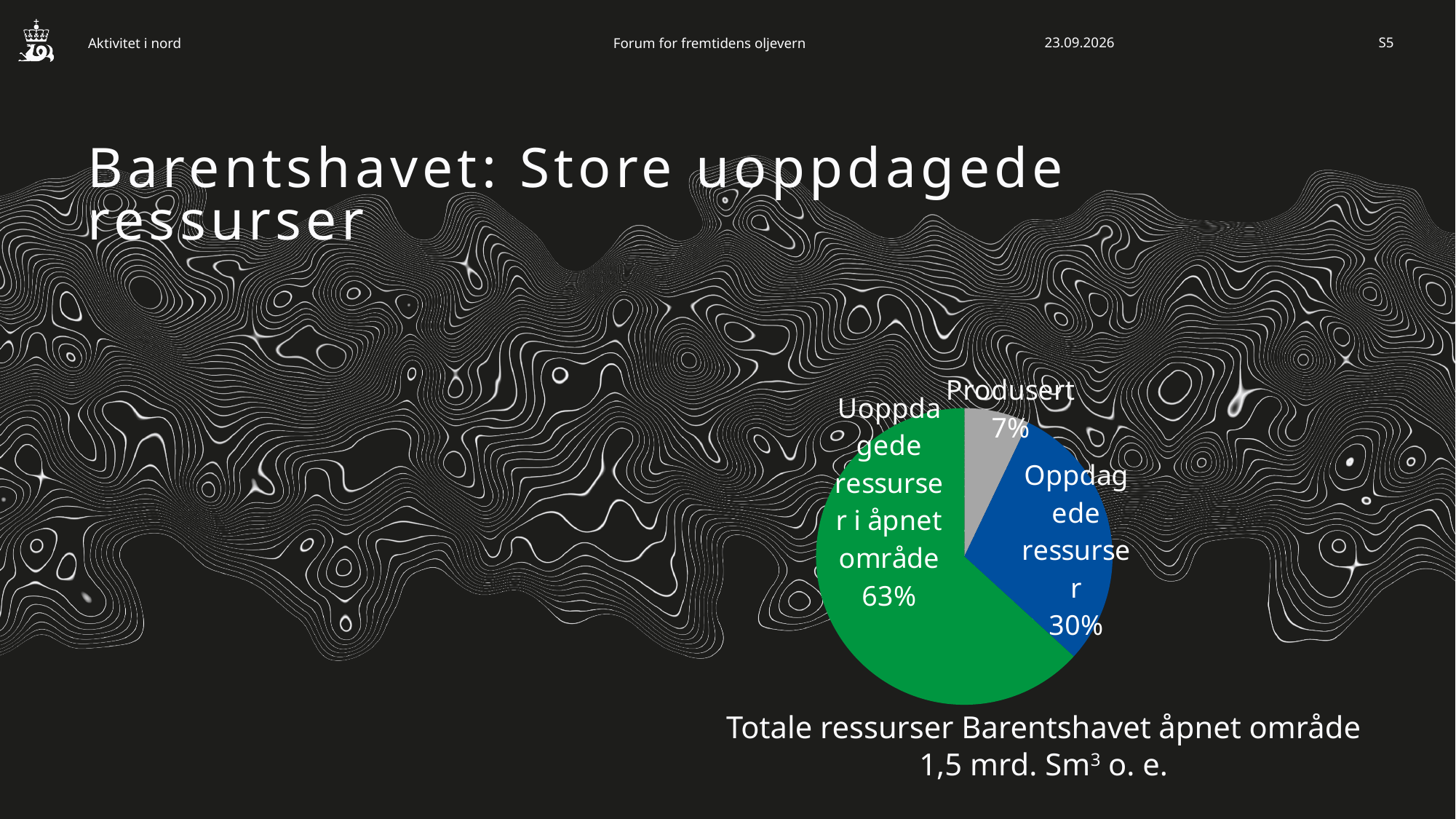
Which slice of the pie chart is the smallest? Produsert What is the difference in percentage points between the "Uoppdagede ressurser i åpnet område" slice and the "Oppdagede ressurser" slice? 33 percentage points What share of the pie is labelled "Uoppdagede ressurser i åpnet område"? 63% How many slices does the pie chart have? 3 What colour is the "Uoppdagede ressurser i åpnet område" slice? Green Which is larger: the "Oppdagede ressurser" slice or the "Produsert" slice? Oppdagede ressurser What is the combined share of the "Oppdagede ressurser" and "Produsert" slices? 37% What kind of chart is shown on the slide? Pie chart What share of the pie is labelled "Produsert"? 7% What total resource amount is stated in the text below the pie chart? 1,5 mrd. Sm³ o. e. Which slice of the pie chart is the largest? Uoppdagede ressurser i åpnet område What share of the pie is labelled "Oppdagede ressurser"? 30%